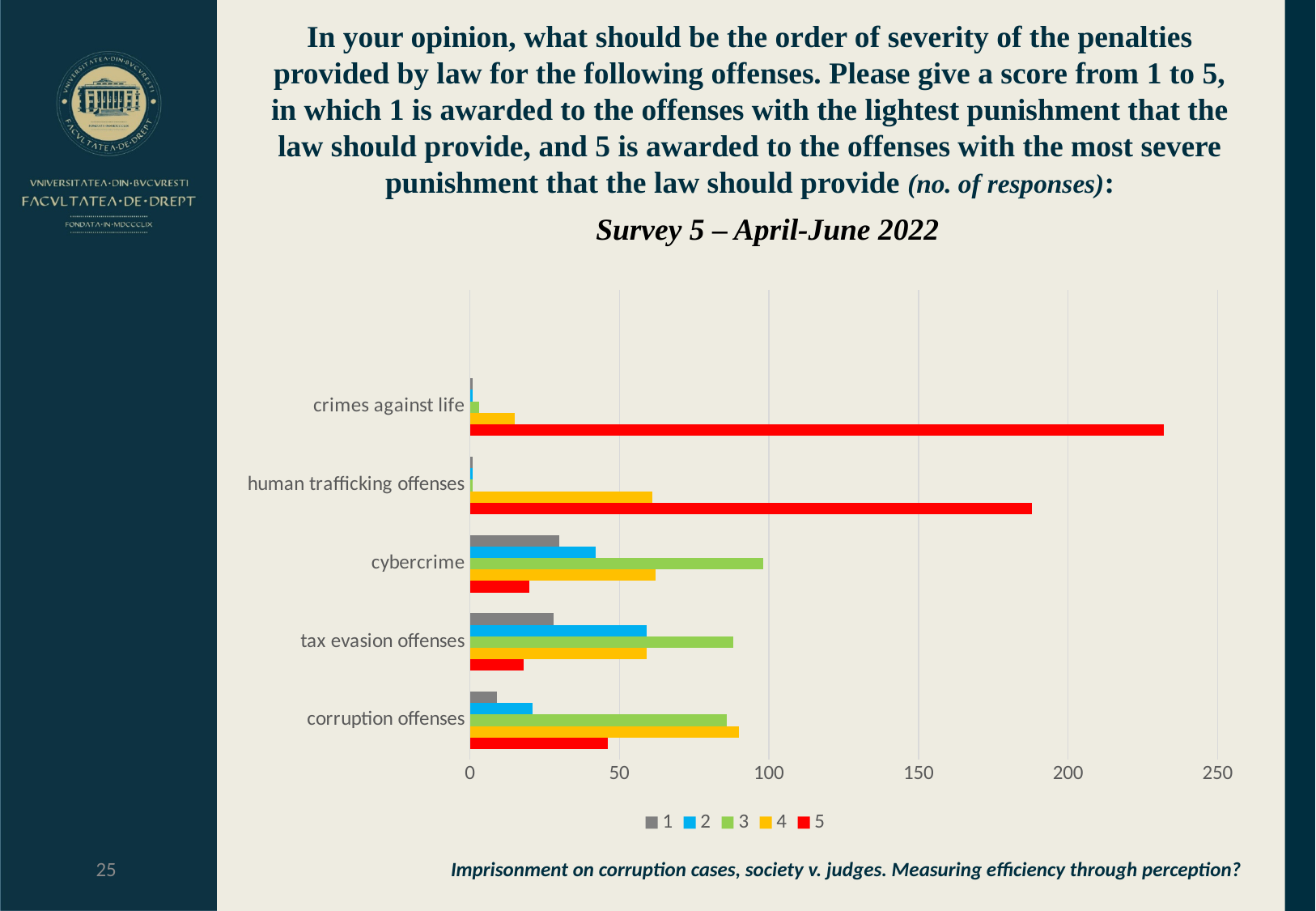
What kind of chart is shown on the slide? bar chart Which offense category has the highest value for score 5? crimes against life How many series does the legend list? 5 What colour represents score 5 in the legend? red Is the value for score 4 for human trafficking offenses greater or less than 50? greater Which is larger: the score 5 value for corruption offenses or the score 5 value for cybercrime? corruption offenses Is the value for score 5 for human trafficking offenses greater or less than 200? less How many offense categories are plotted on the chart? 5 Is the value for score 5 for crimes against life greater or less than 200? greater Which score has the highest number of responses for cybercrime? 3